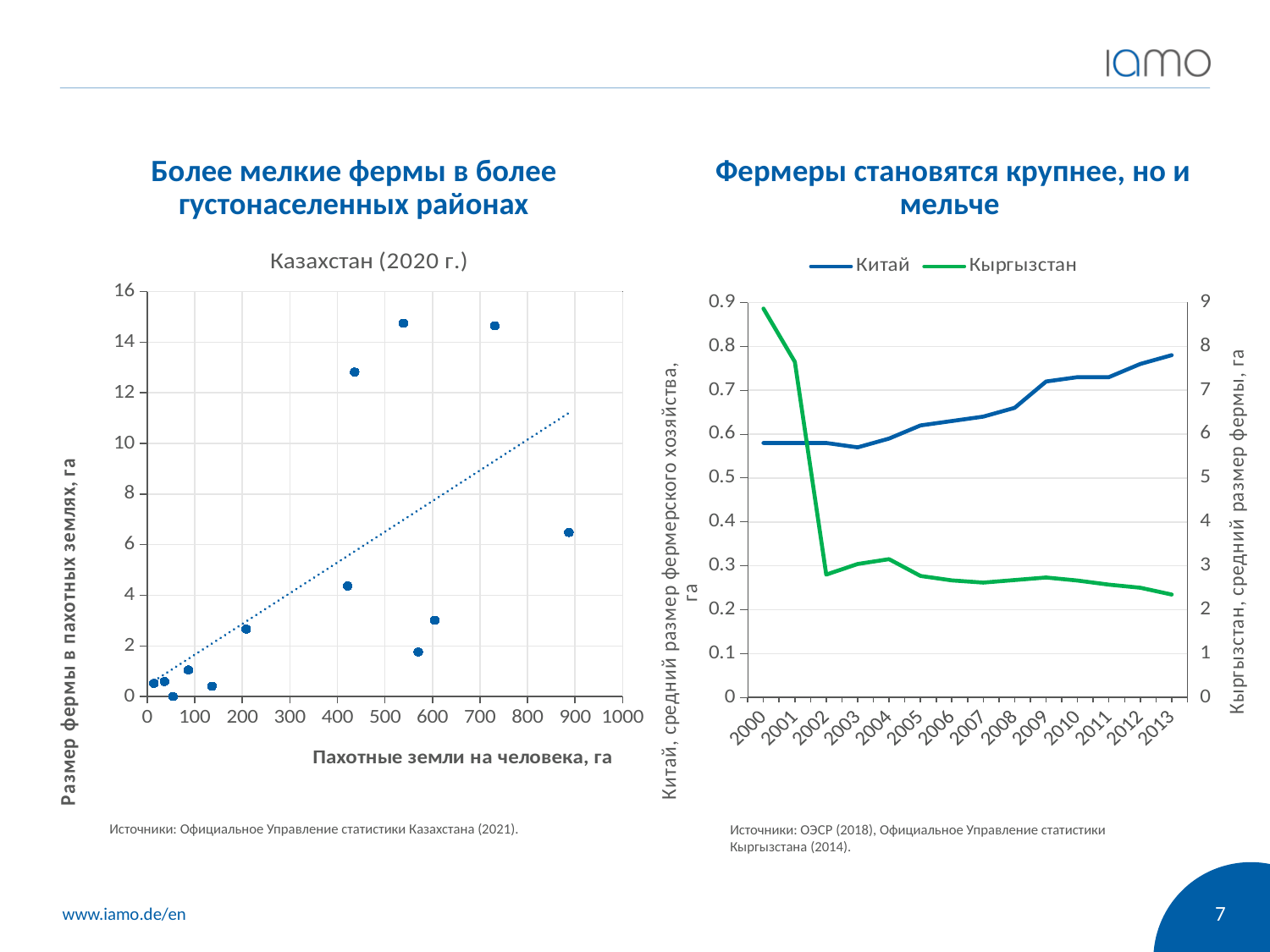
In the right chart, is the Китай value for 2013 greater or less than 0.7 on the left axis? greater What is the x-axis label of the left chart? Пахотные земли на человека, га In the right chart, does the Китай line rise or fall from 2003 to 2013? rise In the right chart, is the Кыргызстан value for 2013 greater or less than 3 on the right axis? less How many series does the legend of the right chart list? 2 In the right chart, in which year is the Кыргызстан value highest? 2000 In the right chart, how many years are shown on the x axis? 14 In the right chart, does the Кыргызстан line rise or fall from 2000 to 2013? fall What kind of chart is the left chart titled "Казахстан (2020 г.)"? scatter chart In the right chart, in which year is the Кыргызстан value lowest? 2013 In the right chart, in which year is the Китай value highest? 2013 What kind of chart is the right chart with the legend "Китай" and "Кыргызстан"? line chart